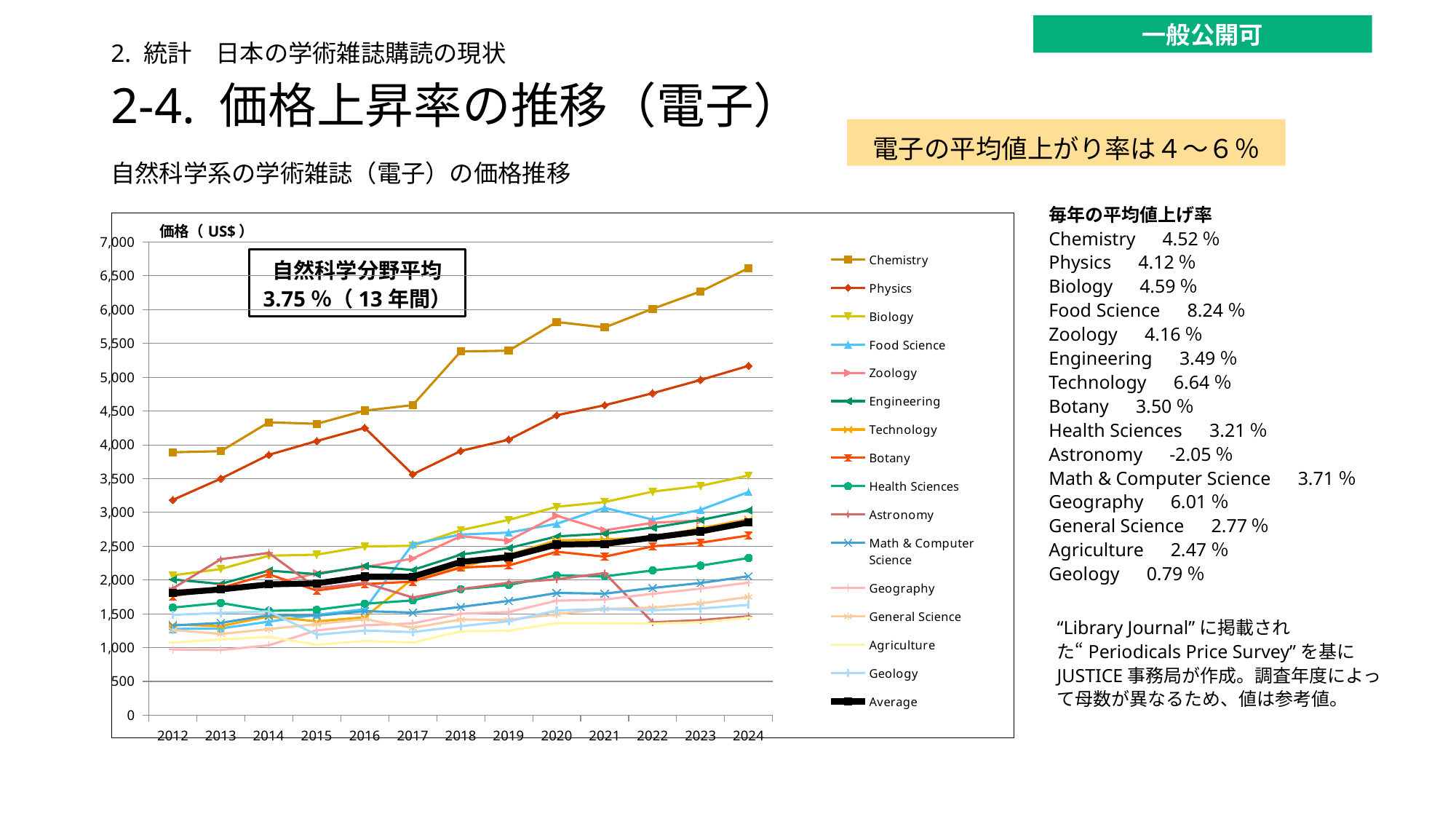
How many series does the chart legend list? 16 Is the value for Physics in 2024 greater or less than 5,000? greater Which is larger in 2024, the value for Chemistry or the value for Physics? Chemistry Which series has the highest value in 2024? Chemistry Is the value for Chemistry in 2024 greater or less than 6,500? greater What kind of chart is shown on the slide? line chart How many years are plotted along the x axis of the chart? 13 Is the value for Physics in 2017 greater or less than 4,000? less What is the label shown on the y axis of the chart? 価格（US$） Does the Chemistry series generally rise or fall from 2012 to 2024? rise